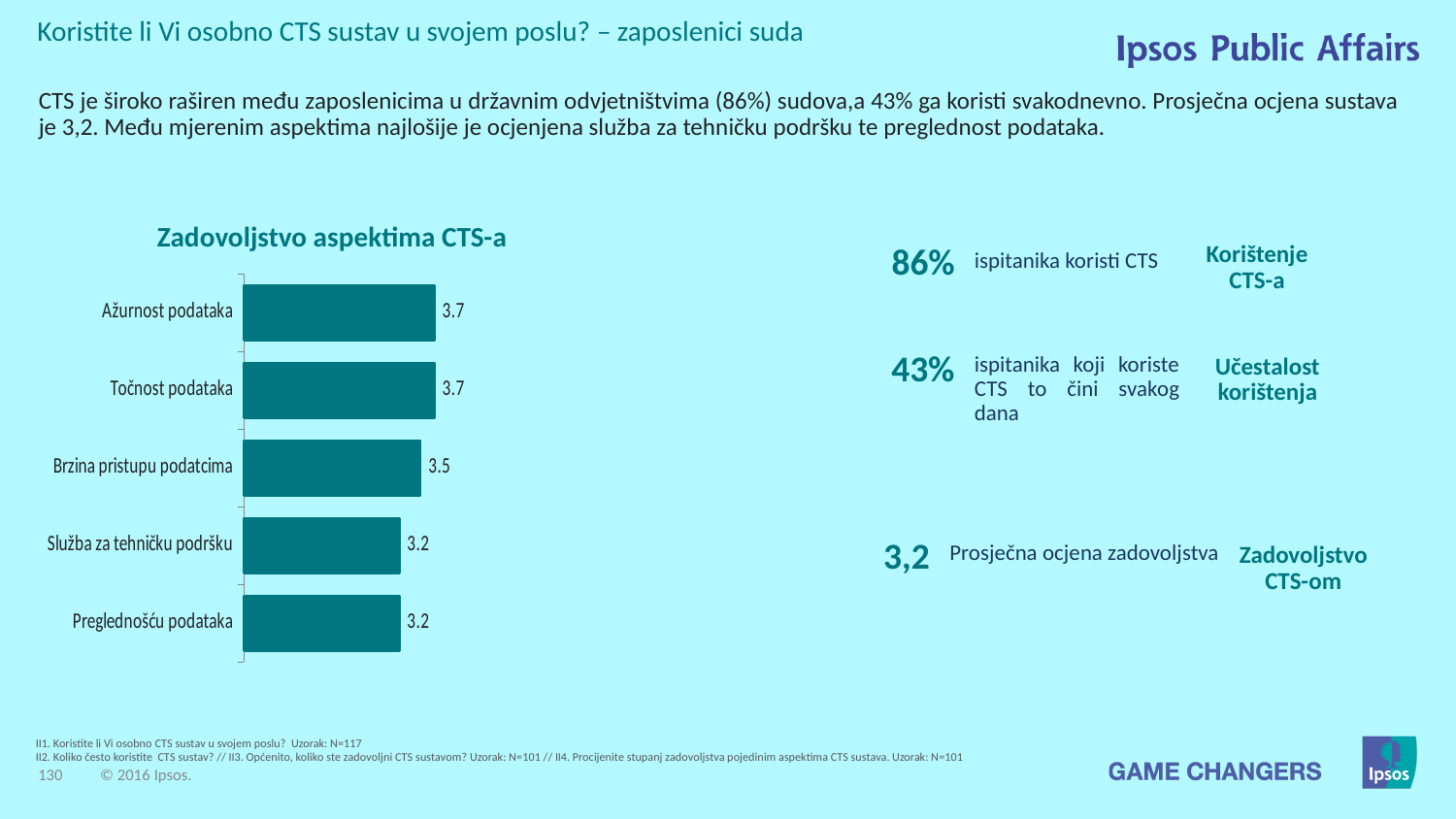
What kind of chart is the Zadovoljstvo aspektima CTS-a chart? Bar chart What is the value for Ažurnost podataka in the Zadovoljstvo aspektima CTS-a chart? 3.7 What is the value for Služba za tehničku podršku in the Zadovoljstvo aspektima CTS-a chart? 3.2 In the Zadovoljstvo aspektima CTS-a chart, which has a larger value: Ažurnost podataka or Brzina pristupu podatcima? Ažurnost podataka What is the value for Točnost podataka in the Zadovoljstvo aspektima CTS-a chart? 3.7 What is the difference between the values for Ažurnost podataka and Brzina pristupu podatcima in the Zadovoljstvo aspektima CTS-a chart? 0.2 What is the title of the chart on the slide? Zadovoljstvo aspektima CTS-a In the Zadovoljstvo aspektima CTS-a chart, which has a larger value: Služba za tehničku podršku or Točnost podataka? Točnost podataka What is the value for Preglednošću podataka in the Zadovoljstvo aspektima CTS-a chart? 3.2 What is the difference between the values for Točnost podataka and Preglednošću podataka in the Zadovoljstvo aspektima CTS-a chart? 0.5 How many categories are shown in the Zadovoljstvo aspektima CTS-a chart? 5 What is the value for Brzina pristupu podatcima in the Zadovoljstvo aspektima CTS-a chart? 3.5